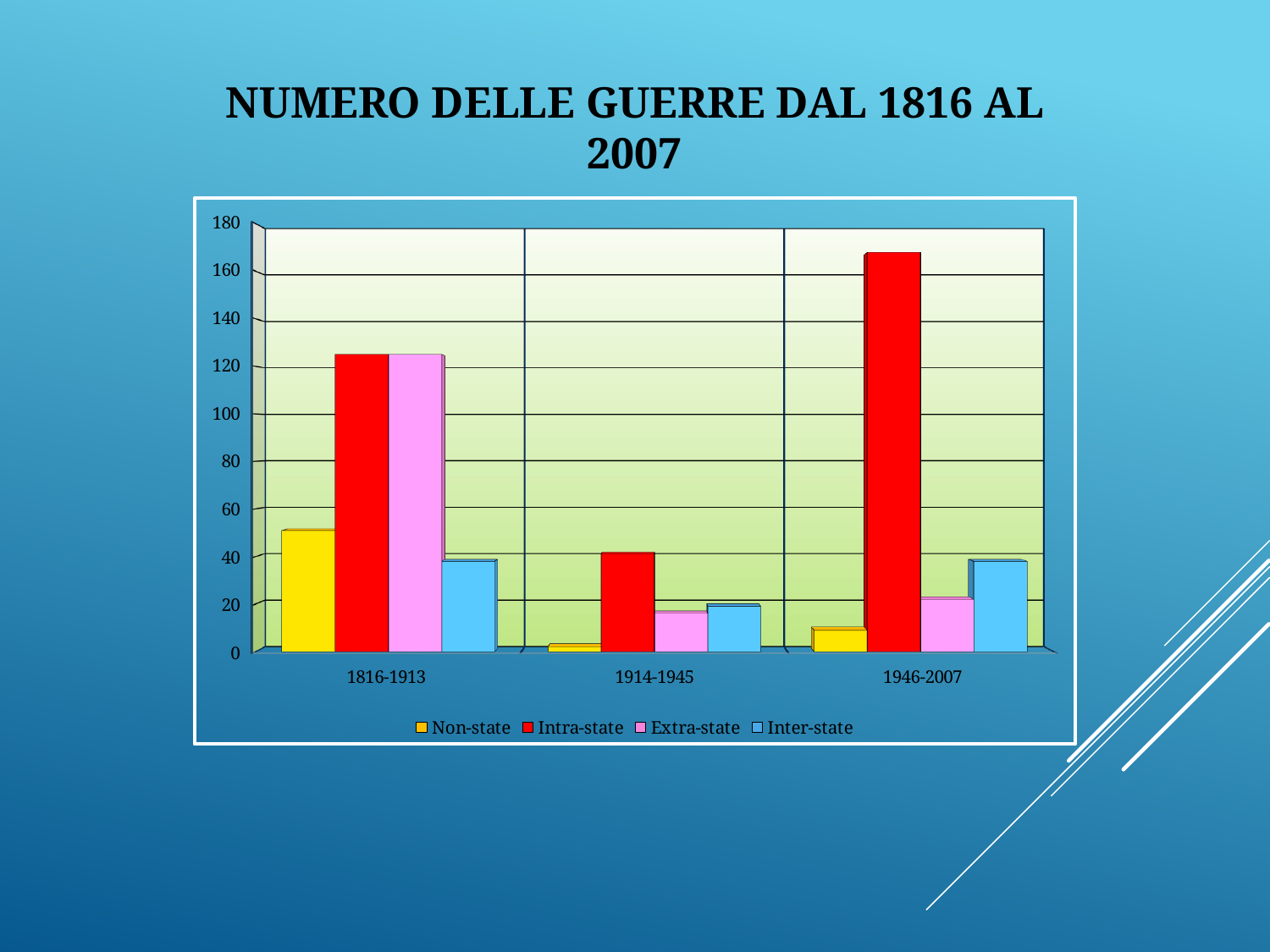
Is the value for Intra-state in 1914-1945 greater or less than 20? greater How many series does the legend list? 4 What colour are the Intra-state bars? red Which series and period has the highest bar in the chart? Intra-state, 1946-2007 Is the value for Intra-state in 1946-2007 greater or less than 140? greater What kind of chart is shown on the slide? bar chart Which series has the lowest bar in the 1914-1945 period? Non-state Does the Intra-state value rise or fall from 1914-1945 to 1946-2007? rise Is the value for Non-state in 1816-1913 greater or less than 60? less How many time periods are shown on the x axis? 3 Which is larger: Intra-state in 1816-1913 or Intra-state in 1946-2007? Intra-state in 1946-2007